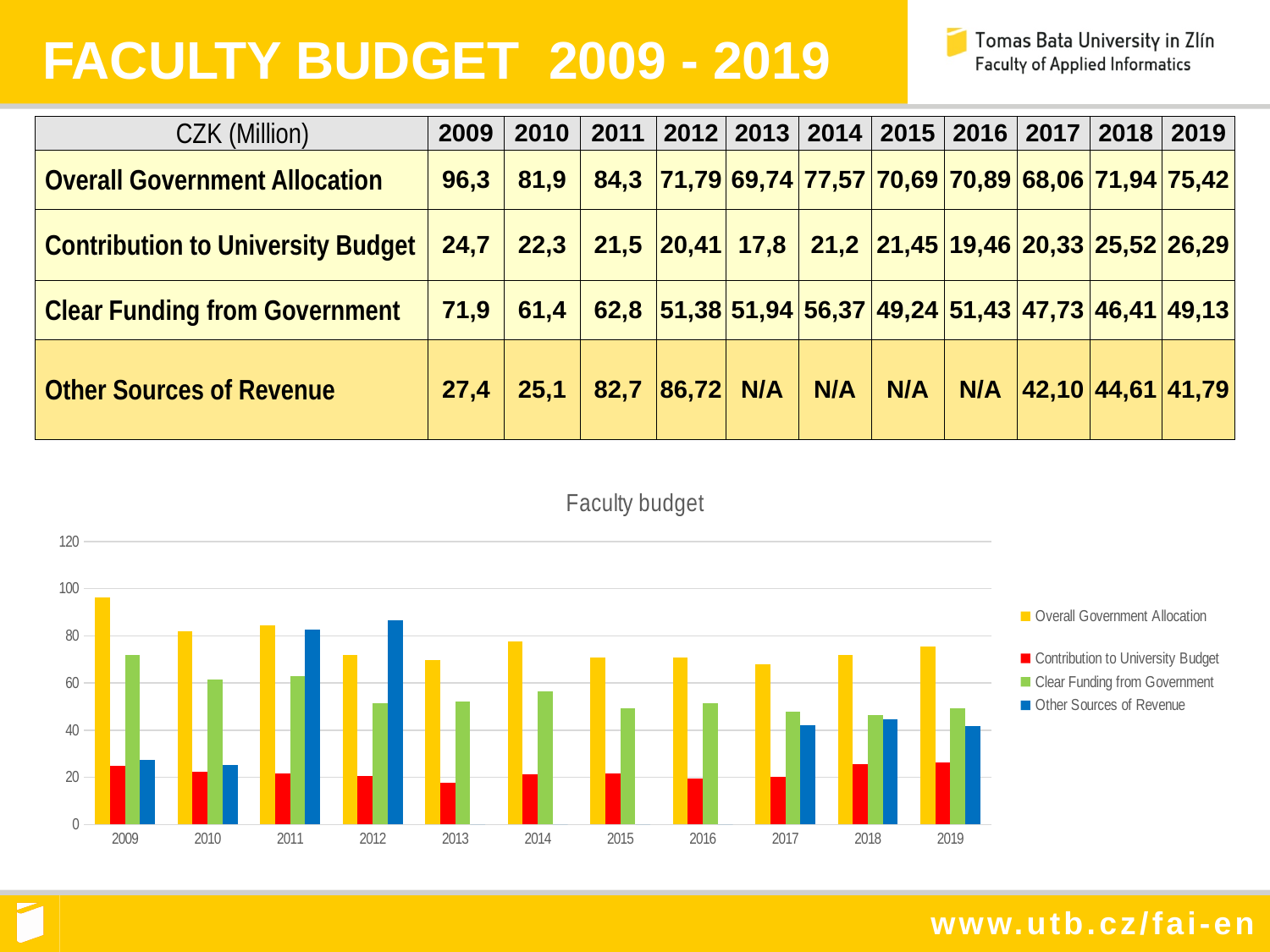
Is the Overall Government Allocation for 2017 greater or less than 80? less Which colour represents Other Sources of Revenue in the "Faculty budget" chart? blue In which year is the Contribution to University Budget lowest? 2013 Does the Contribution to University Budget rise or fall from 2017 to 2019? rise Which is larger in 2011: Other Sources of Revenue or Clear Funding from Government? Other Sources of Revenue What is the Other Sources of Revenue value for 2012 (CZK million)? 86,72 What is the Overall Government Allocation for 2009 (CZK million)? 96,3 In which year is the Overall Government Allocation highest? 2009 How many series does the legend of the "Faculty budget" chart list? 4 How many years are shown along the x axis of the "Faculty budget" chart? 11 What type of chart is shown under the title "Faculty budget"? bar chart What is the difference between Overall Government Allocation and Clear Funding from Government in 2009? 24,4